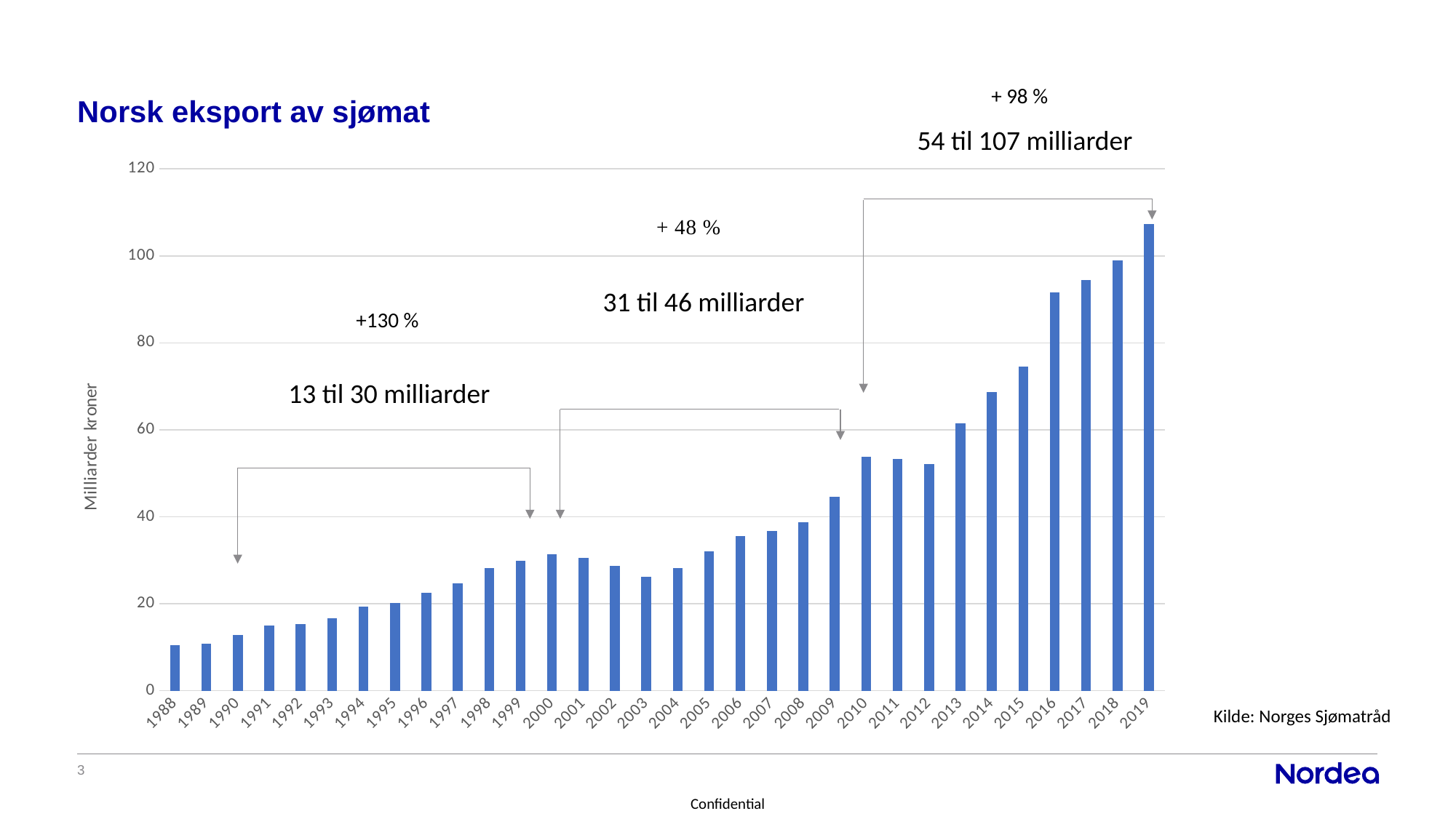
Do the values generally rise or fall from 1988 to 2019? rise What is the label on the vertical axis of the chart? Milliarder kroner Is the value for 2010 greater or less than 40? greater How many years (bars) are plotted in the chart? 32 Which year has the larger value, 2018 or 2019? 2019 Which year has the highest value in the chart? 2019 Is the value for 1988 greater or less than 20? less Which year has the larger value, 2003 or 2005? 2005 Is the value for 2019 greater or less than 100? greater What kind of chart is shown on the slide? bar chart